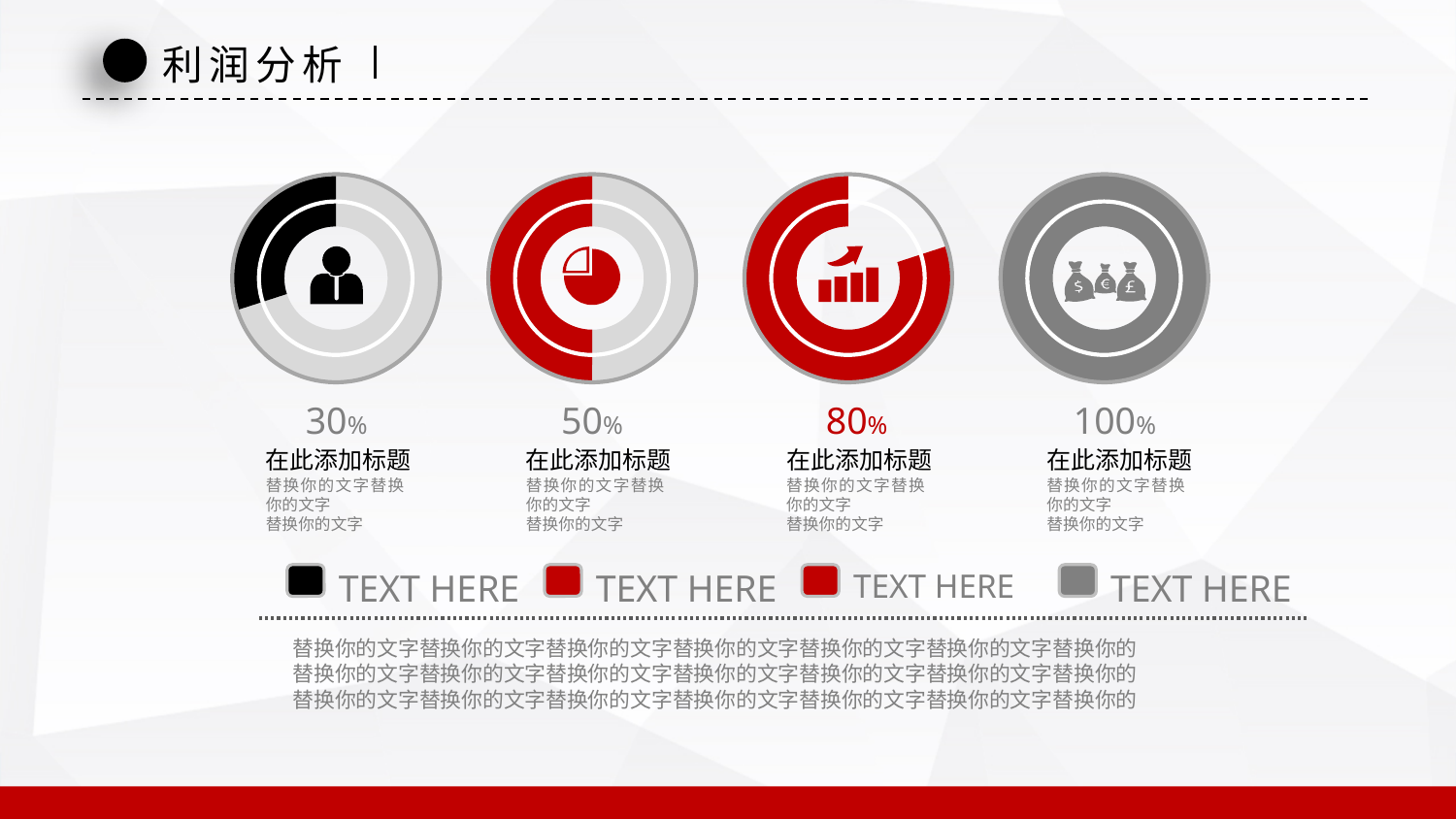
What percentage is shown below the fourth (rightmost) circular chart? 100% What percentage is shown below the second circular chart from the left? 50% Which is larger, the percentage of the second chart or the percentage of the third chart? The third chart (80%) What percentage is shown below the third circular chart from the left? 80% How many circular progress charts are shown on the slide? 4 What percentage is shown below the first (leftmost) circular chart? 30% Which circular chart shows the lowest percentage? The first (leftmost) chart, 30% Which circular chart shows the highest percentage? The fourth (rightmost) chart, 100% Do the percentages increase or decrease from left to right across the four charts? Increase What colour is the filled ring of the first (leftmost) circular chart? Black What is the difference between the percentage of the fourth chart and the percentage of the second chart? 50% What is the difference between the percentage of the third chart and the percentage of the first chart? 50%